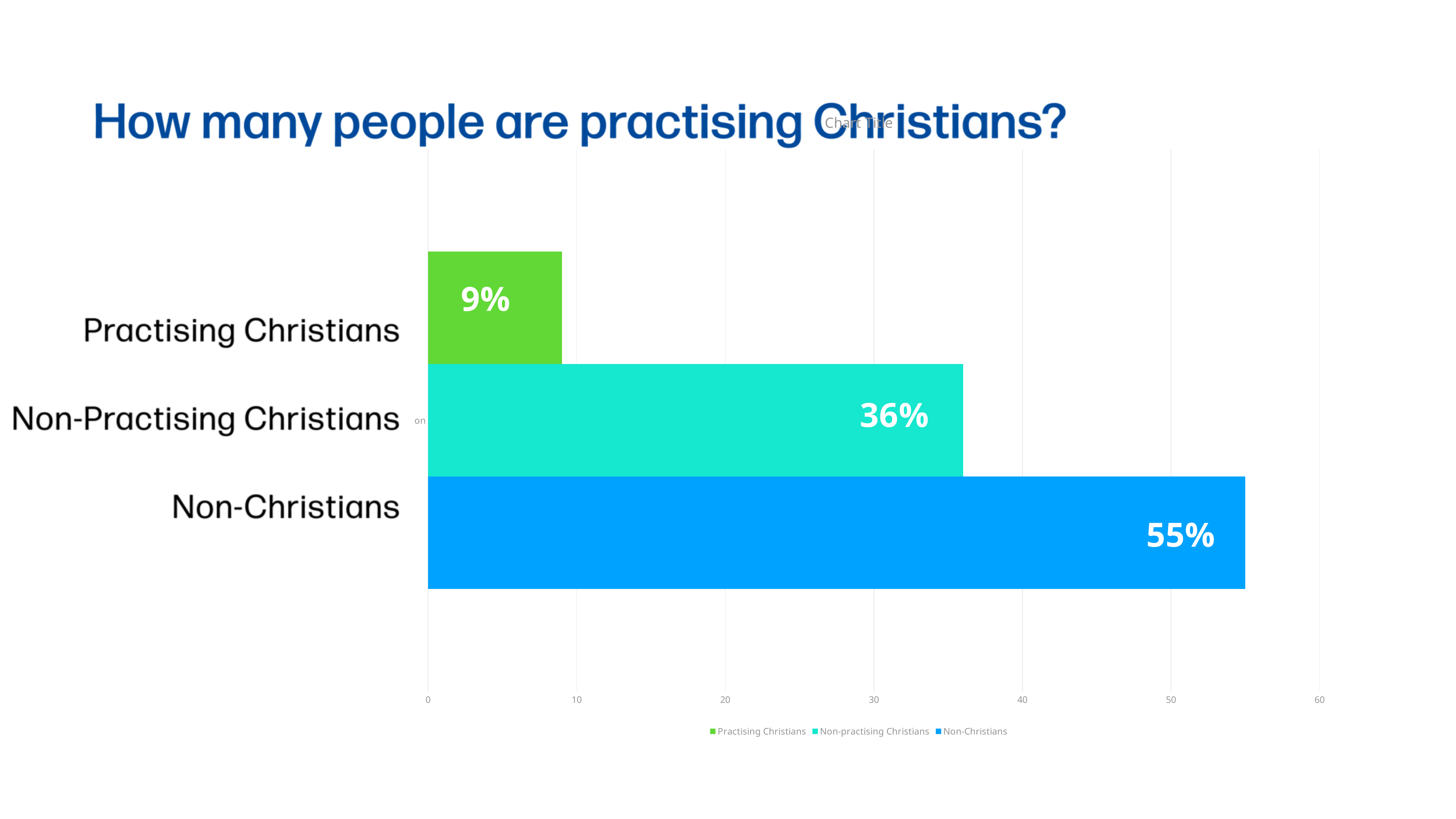
How many entries does the legend list? 3 Which is larger, the value for Non-Practising Christians or the value for Practising Christians? Non-Practising Christians Is the value for Non-Christians greater or less than 50? greater What kind of chart is shown on the slide? bar chart What is the value for Non-Practising Christians? 36% What is the value for Practising Christians? 9% What is the difference between the values for Non-Practising Christians and Practising Christians? 27% Which category has the highest value? Non-Christians Which category has the lowest value? Practising Christians How many categories are shown in the chart? 3 What is the value for Non-Christians? 55% What is the difference between the values for Non-Christians and Non-Practising Christians? 19%